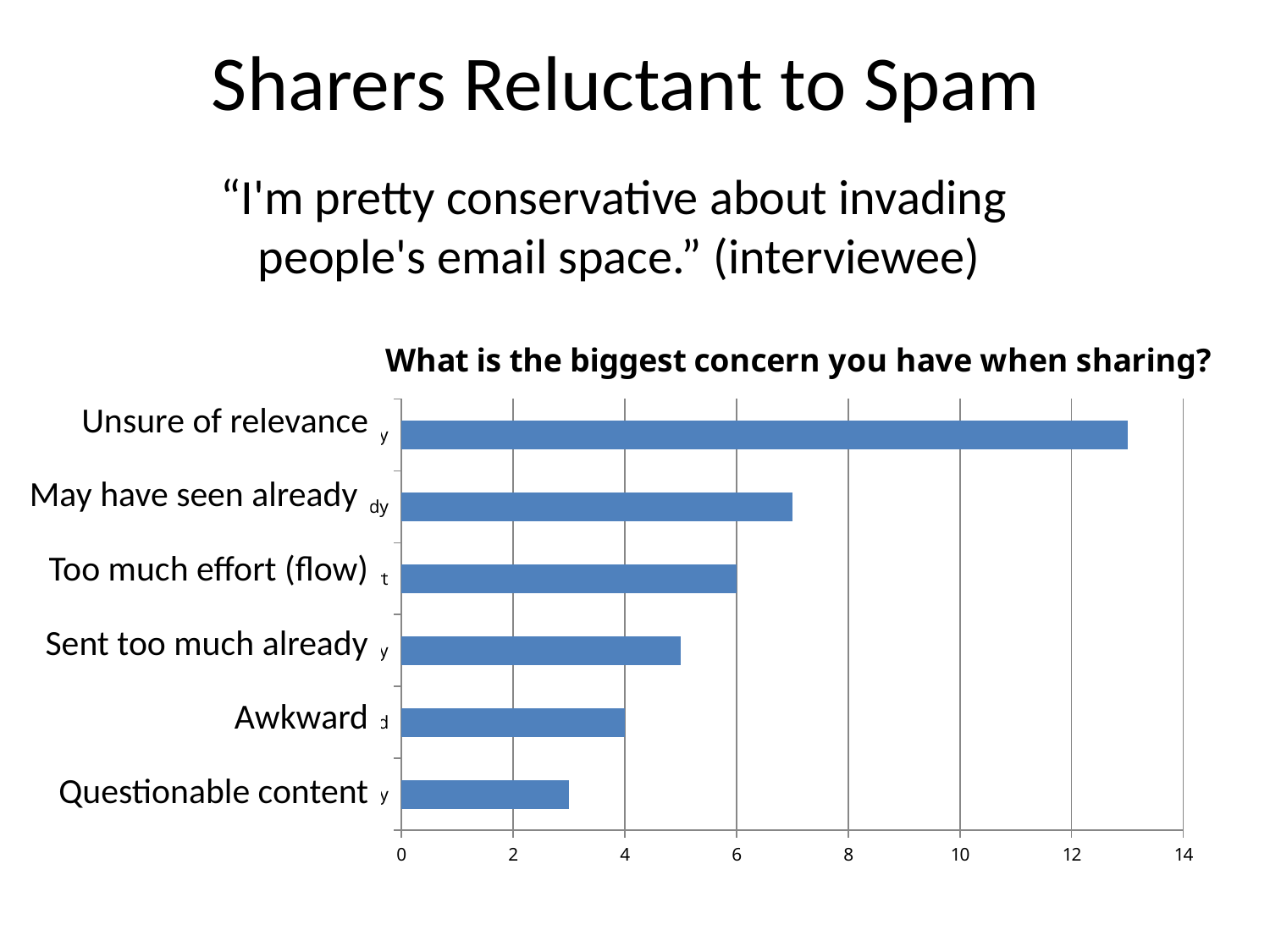
Which category has the highest value? Unsure of relevance What is the value for Too much effort (flow)? 6 Which is larger, the value for Sent too much already or the value for Awkward? Sent too much already Is the value for Questionable content greater or less than 4? less What is the value for Awkward? 4 Which category has the lowest value? Questionable content What type of chart is shown on the slide? bar chart What is the title of the chart? What is the biggest concern you have when sharing? Is the value for Unsure of relevance greater or less than 12? greater How many categories are shown in the chart? 6 What is the difference between the values for Too much effort (flow) and Awkward? 2 Is the value for May have seen already greater or less than 6? greater